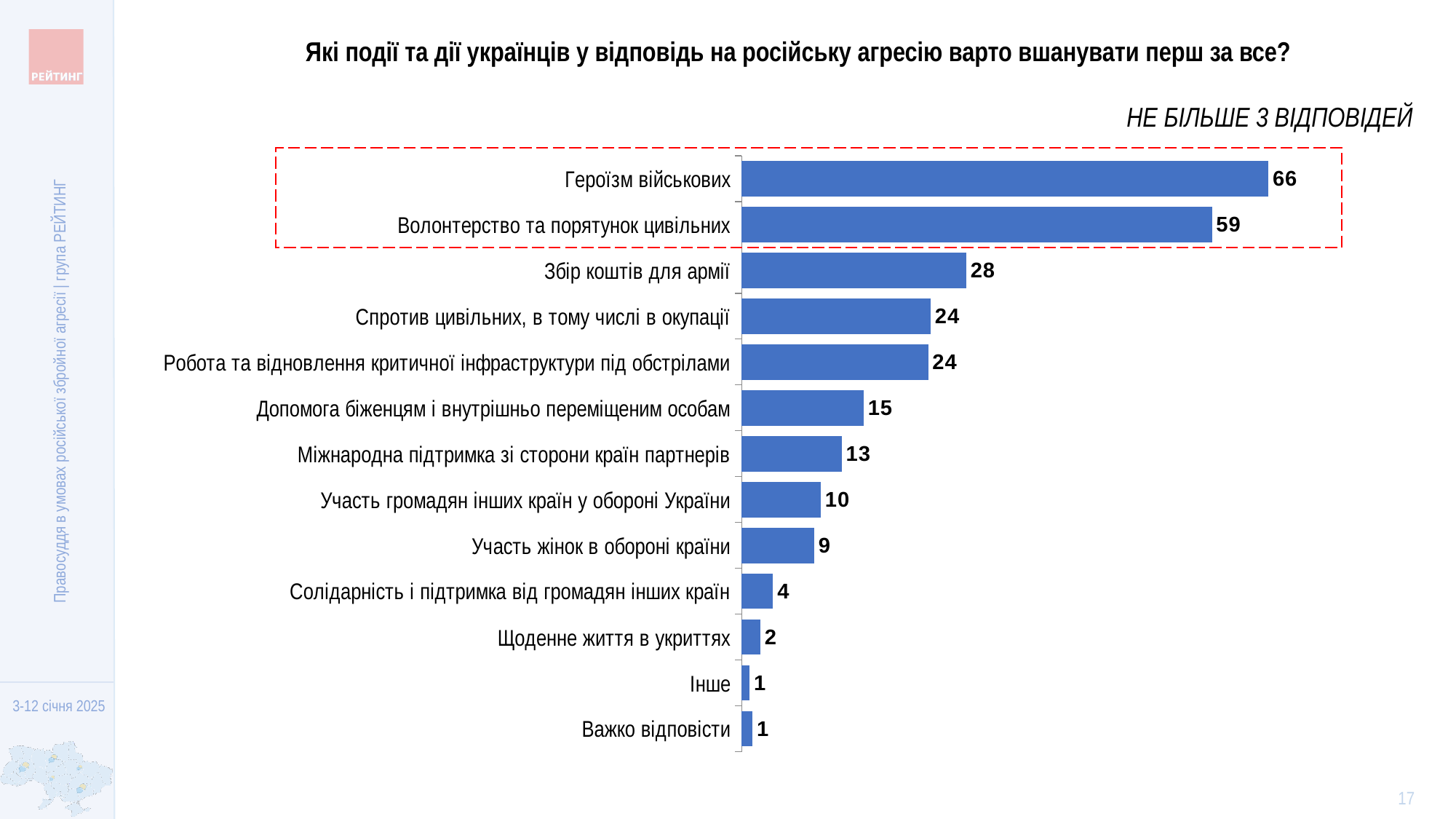
What type of chart is shown on the slide? Bar chart What value is shown for "Участь жінок в обороні країни"? 9 Which category has the highest value? Героїзм військових What value is shown for "Допомога біженцям і внутрішньо переміщеним особам"? 15 What value is shown for "Збір коштів для армії"? 28 How many categories are enclosed by the red dashed box? 2 What value is shown for "Волонтерство та порятунок цивільних"? 59 What is the difference between the values for "Збір коштів для армії" and "Міжнародна підтримка зі сторони країн партнерів"? 15 Which is larger: the value for "Участь громадян інших країн у обороні України" or the value for "Солідарність і підтримка від громадян інших країн"? Участь громадян інших країн у обороні України What value is shown for "Героїзм військових"? 66 How many categories are shown in the chart? 13 What is the difference between the values for "Героїзм військових" and "Волонтерство та порятунок цивільних"? 7